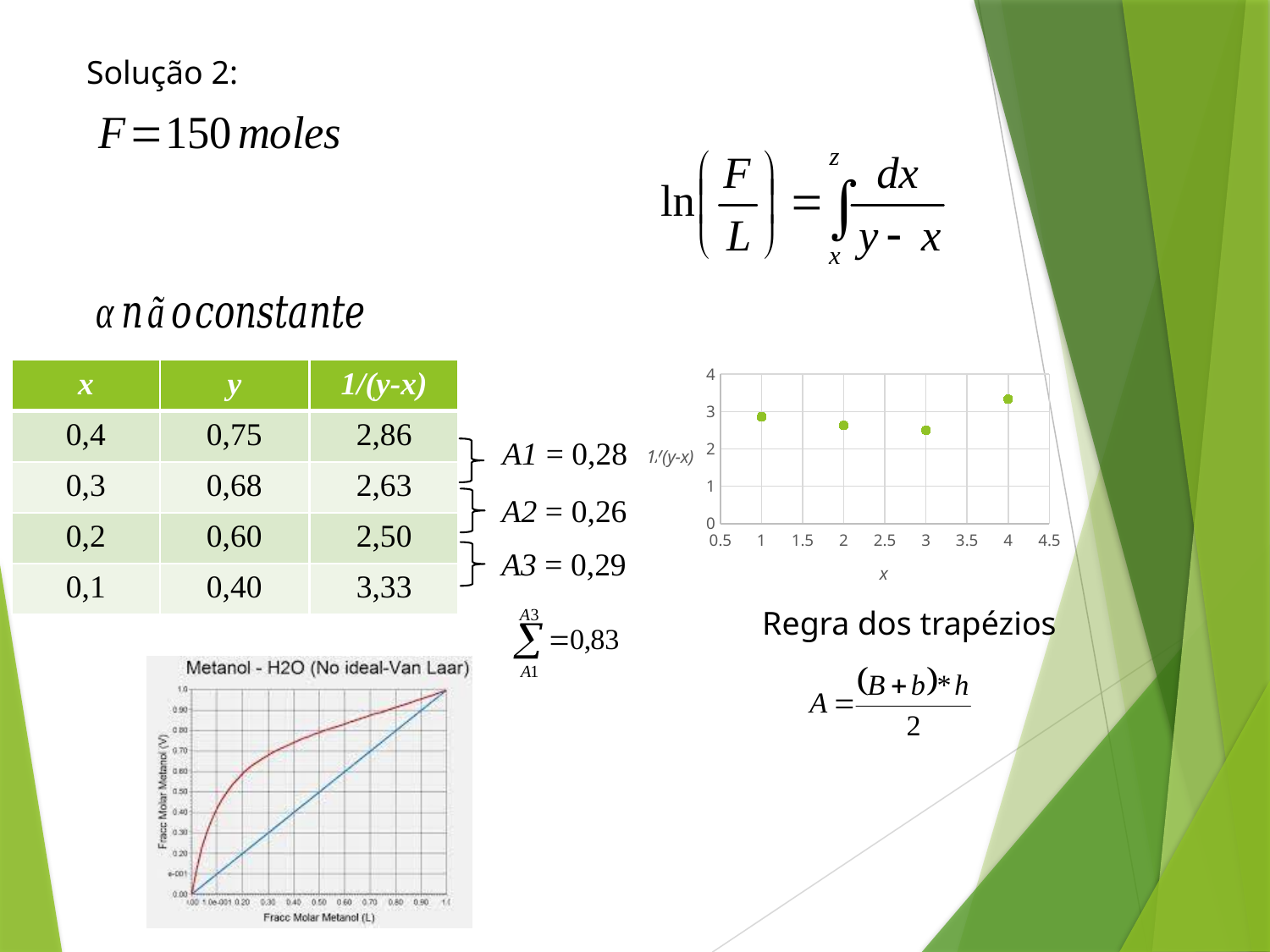
In the scatter chart on the right, is the value at x = 2 greater or less than 2? greater What is the title of the chart at the bottom left of the slide? Metanol - H2O (No ideal-Van Laar) In the scatter chart on the right, is the value at x = 3 greater or less than 3? less In the scatter chart on the right, which point is higher: the one at x = 4 or the one at x = 3? x = 4 In the scatter chart on the right, what kind of chart is it? scatter chart In the chart at the bottom left of the slide, how many lines are plotted? 2 In the scatter chart on the right, how many data points are plotted? 4 In the scatter chart on the right, what is the label on the vertical axis? 1/(y-x) In the chart at the bottom left of the slide, what kind of chart is it? line chart In the scatter chart on the right, at which x value is the plotted point highest? 4 In the scatter chart on the right, is the value at x = 4 greater or less than 3? greater In the scatter chart on the right, at which x value is the plotted point lowest? 3